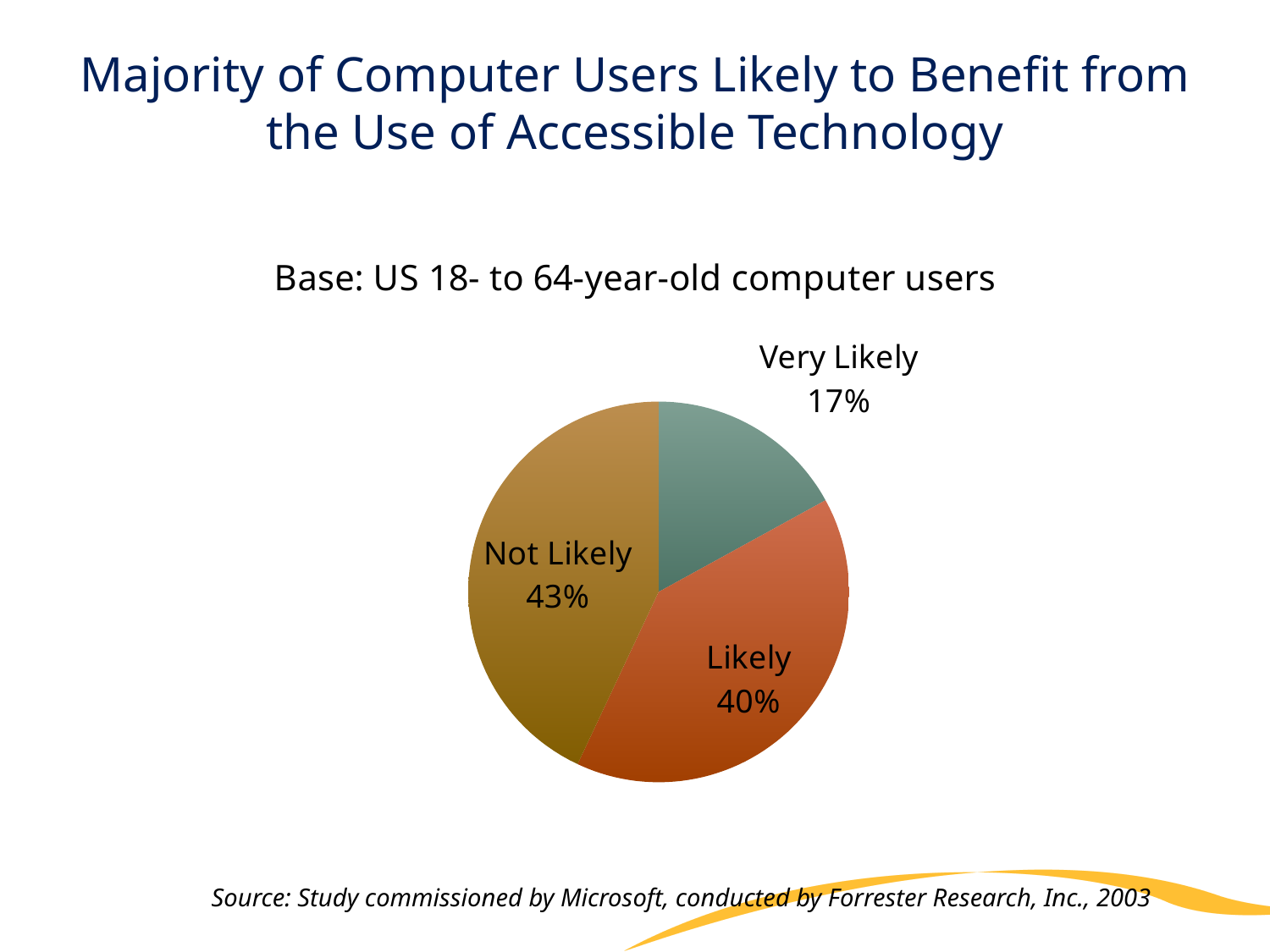
Which slice of the pie is the largest? Not Likely What is the difference in percentage points between the "Not Likely" and "Likely" slices? 3 What base population is stated above the pie chart? US 18- to 64-year-old computer users What kind of chart is shown on the slide? pie chart What is the difference in percentage points between the "Likely" and "Very Likely" slices? 23 What percentage of computer users are labelled "Very Likely" to benefit? 17% What percentage of computer users are labelled "Not Likely" to benefit? 43% How many slices does the pie chart have? 3 What percentage of computer users are labelled "Likely" to benefit? 40% Which is larger, the "Likely" slice or the "Very Likely" slice? Likely Which slice of the pie is the smallest? Very Likely What is the combined share of the "Very Likely" and "Likely" slices? 57%